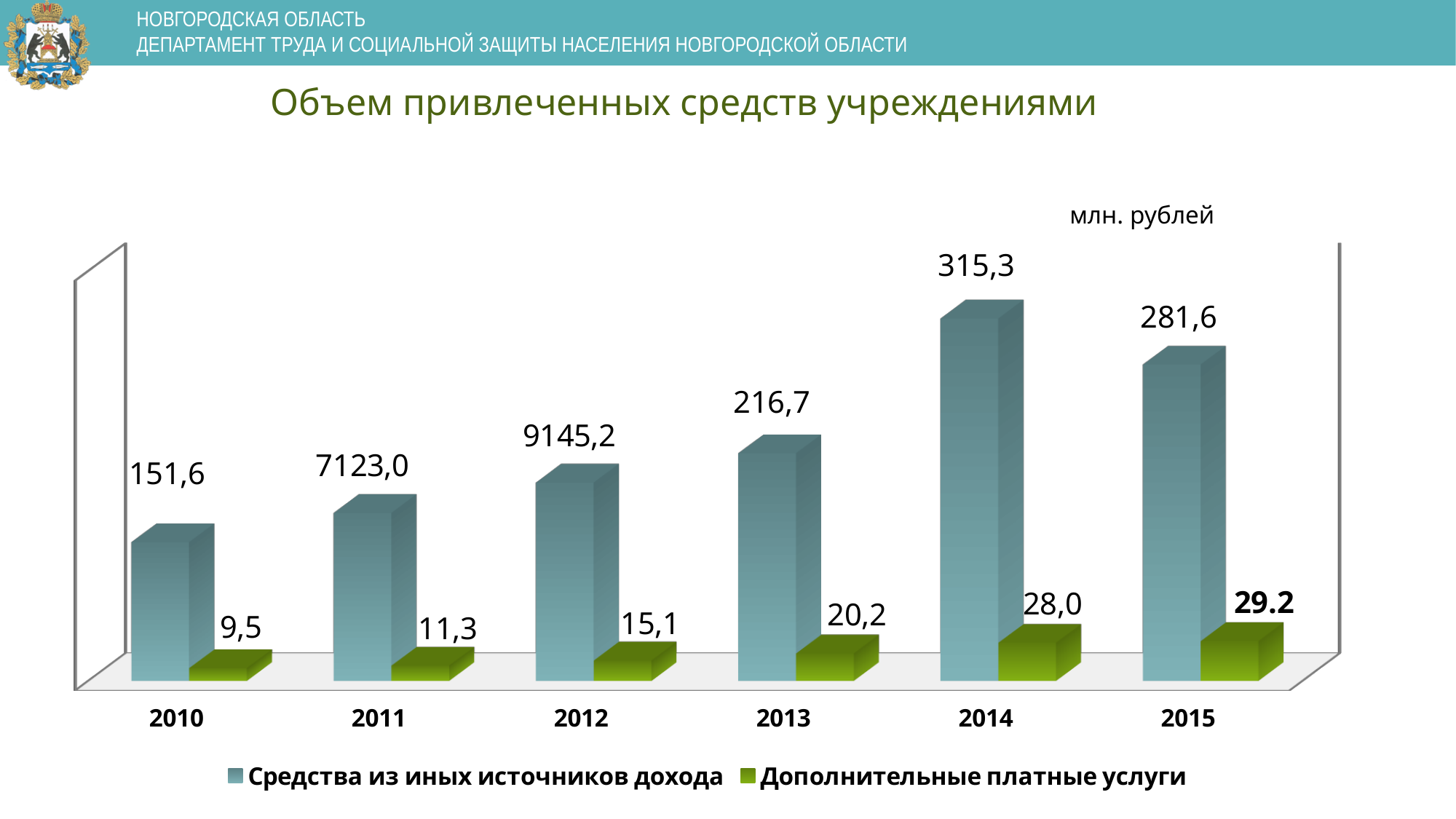
Does the value for "Дополнительные платные услуги" rise or fall from 2010 to 2015? Rises What is the value for "Дополнительные платные услуги" in 2010? 9,5 What is the value for "Средства из иных источников дохода" in 2014? 315,3 What unit is stated above the chart? млн. рублей What is the value for "Средства из иных источников дохода" in 2015? 281,6 In which year is "Средства из иных источников дохода" highest? 2014 What is the value for "Дополнительные платные услуги" in 2013? 20,2 What type of chart is shown on the slide? Bar chart How many years are shown on the x axis of the chart? 6 What is the difference between the 2014 and 2013 values for "Средства из иных источников дохода"? 98,6 In which year is "Дополнительные платные услуги" lowest? 2010 How many series does the chart legend list? 2